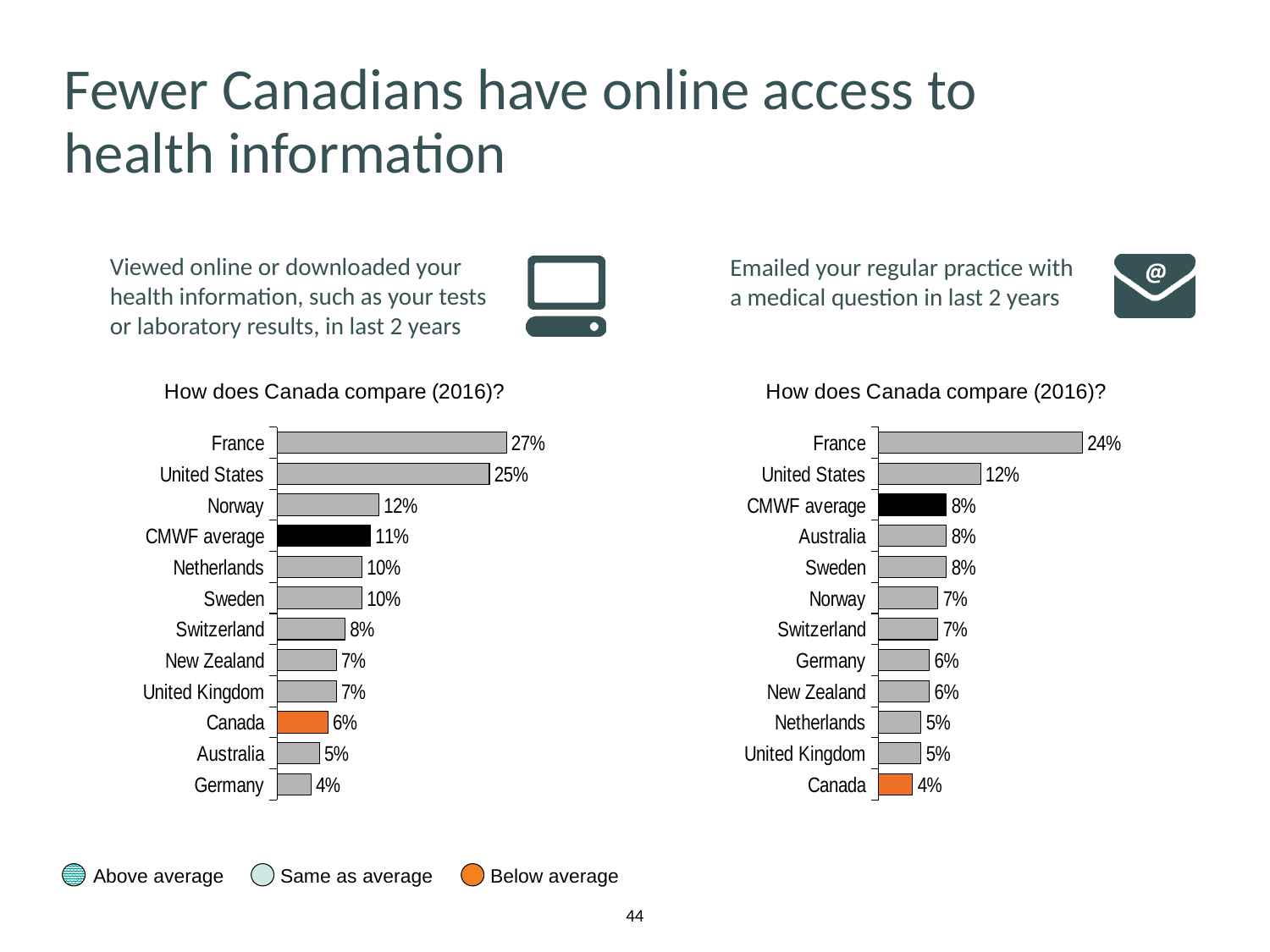
In the left chart (viewed online or downloaded health information), what is the value for Canada? 6% In the right chart (emailed regular practice with a medical question), what is the value for Canada? 4% In the left chart (viewed online or downloaded health information), which is larger, Norway or Switzerland? Norway In the left chart (viewed online or downloaded health information), what is the difference between France and the United States? 2% In the right chart (emailed regular practice with a medical question), which country has the lowest value? Canada In the right chart (emailed regular practice with a medical question), what is the CMWF average? 8% In the left chart (viewed online or downloaded health information), what is the CMWF average? 11% What type of chart is the left chart (viewed online or downloaded health information)? Bar chart How many countries or categories are shown in the right chart (emailed regular practice with a medical question)? 12 In the left chart (viewed online or downloaded health information), which country has the highest value? France In the right chart (emailed regular practice with a medical question), what is the difference between France and the United States? 12% In the left chart (viewed online or downloaded health information), what is the value for Germany? 4%